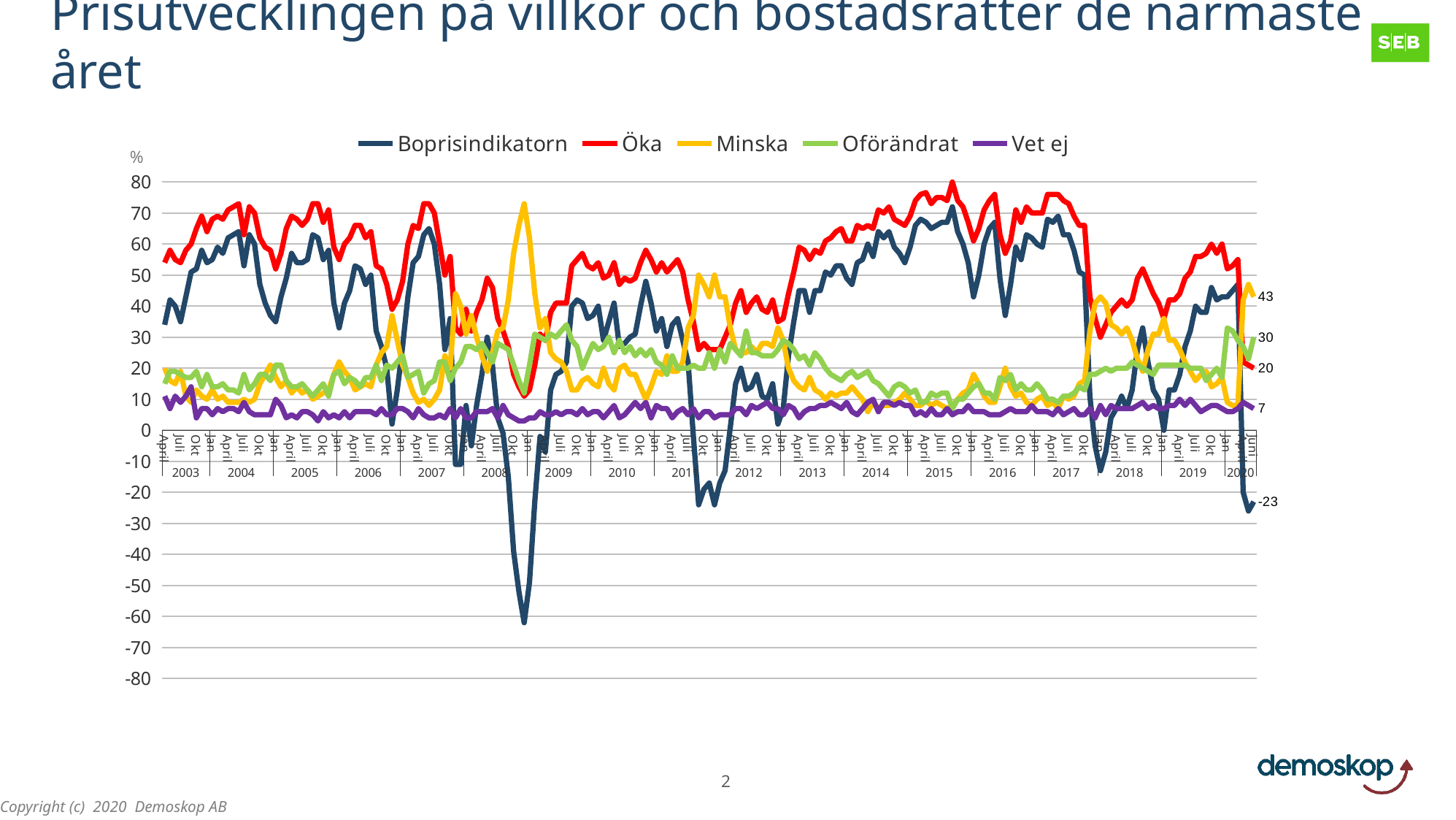
What is the final labelled value for the Öka series at the right end of the chart? 20 What is the difference between the final labelled values of Minska and Öka? 23 What is the final labelled value for the Oförändrat series at the right end of the chart? 30 Which series has the highest labelled value at the right end of the chart? Minska Which series is drawn in red in the legend? Öka What is the final labelled value for the Minska series at the right end of the chart? 43 Which series has the lowest labelled value at the right end of the chart? Boprisindikatorn How many series does the legend list? 5 What is the final labelled value for the Boprisindikatorn series at the right end of the chart? -23 At the right end of the chart, which is larger: the final value of Oförändrat or the final value of Öka? Oförändrat What is the final labelled value for the Vet ej series at the right end of the chart? 7 What kind of chart is shown on the slide? line chart